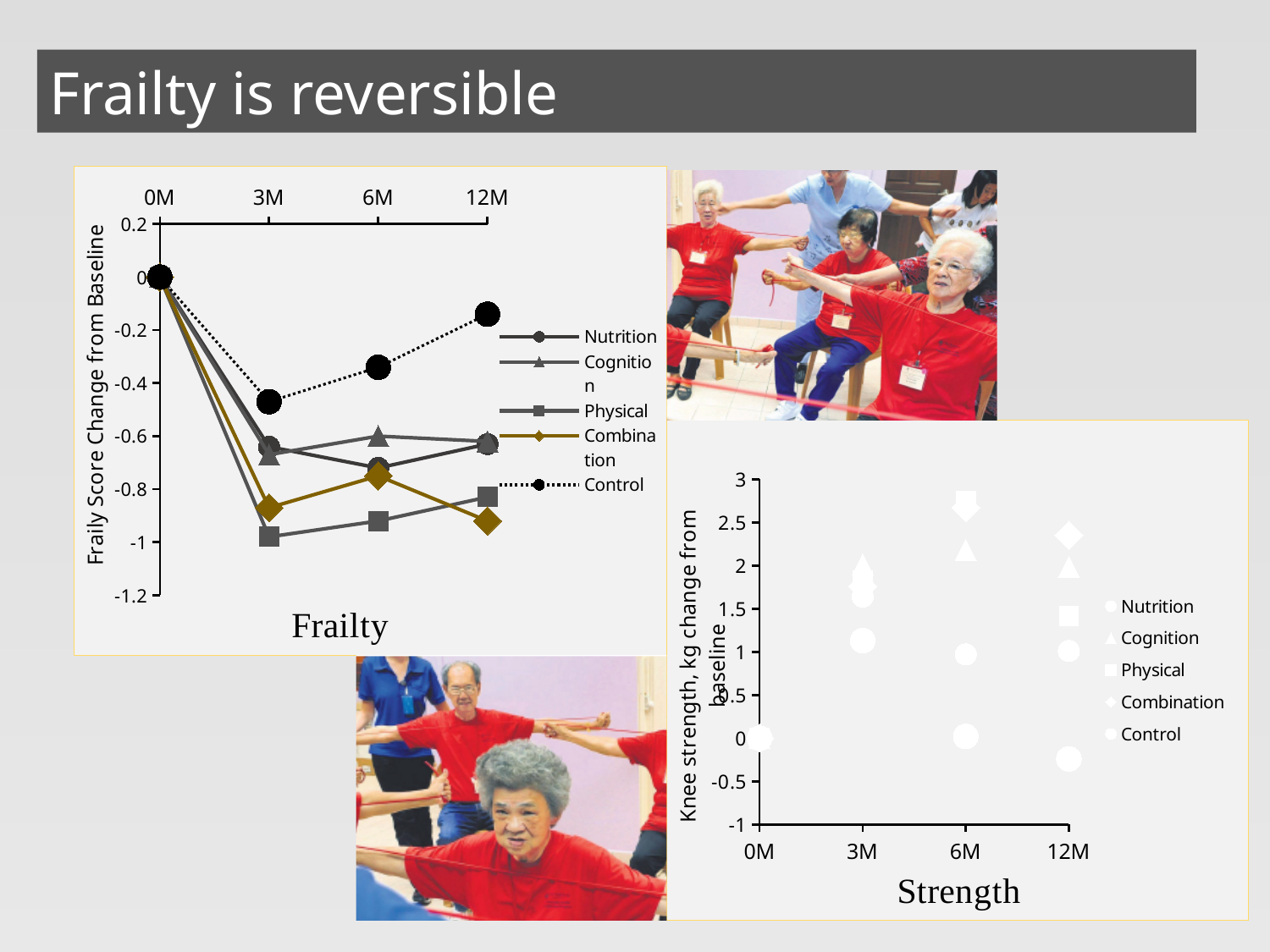
What kind of chart is the Strength chart? scatter chart On the Strength chart, is the value for Control at 12M greater or less than 0? less On the Frailty chart, is the value for Physical at 3M greater or less than -0.8? less On the Frailty chart, is the value for Control at 12M greater or less than -0.2? greater On the Frailty chart, how many series does the legend list? 5 On the Frailty chart, does the Control series rise or fall from 3M to 12M? rise On the Frailty chart, how many time points are shown on the x axis? 4 What kind of chart is the Frailty chart? line chart What is the y-axis label of the Strength chart? Knee strength, kg change from baseline